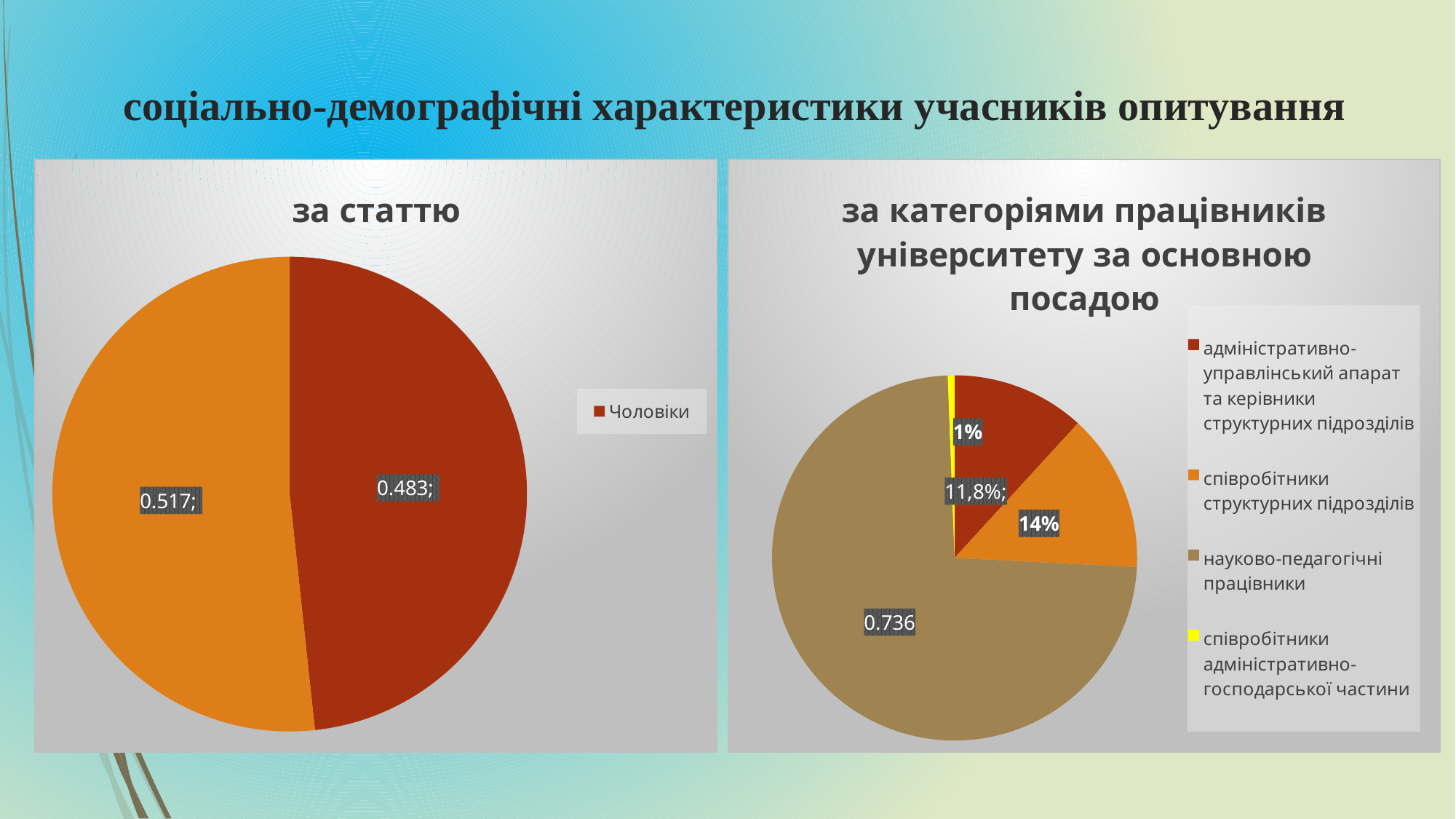
What kind of chart is the chart titled "за статтю"? pie chart In the chart titled "за категоріями працівників університету за основною посадою", what value is shown for співробітники адміністративно-господарської частини? 1% In the chart titled "за категоріями працівників університету за основною посадою", which category has the smallest slice? співробітники адміністративно-господарської частини In the chart titled "за категоріями працівників університету за основною посадою", how many categories does the legend list? 4 In the chart titled "за статтю", what value is shown for Чоловіки? 0.483 In the chart titled "за категоріями працівників університету за основною посадою", what value is shown for науково-педагогічні працівники? 0.736 In the chart titled "за статтю", what value is shown on the orange slice? 0.517 In the chart titled "за статтю", how many series does the legend list? 1 In the chart titled "за категоріями працівників університету за основною посадою", which category has the largest slice? науково-педагогічні працівники In the chart titled "за категоріями працівників університету за основною посадою", what value is shown for співробітники структурних підрозділів? 14% In the chart titled "за статтю", which slice is larger, the orange slice or the Чоловіки slice? the orange slice In the chart titled "за категоріями працівників університету за основною посадою", what value is shown for адміністративно-управлінський апарат та керівники структурних підрозділів? 11,8%